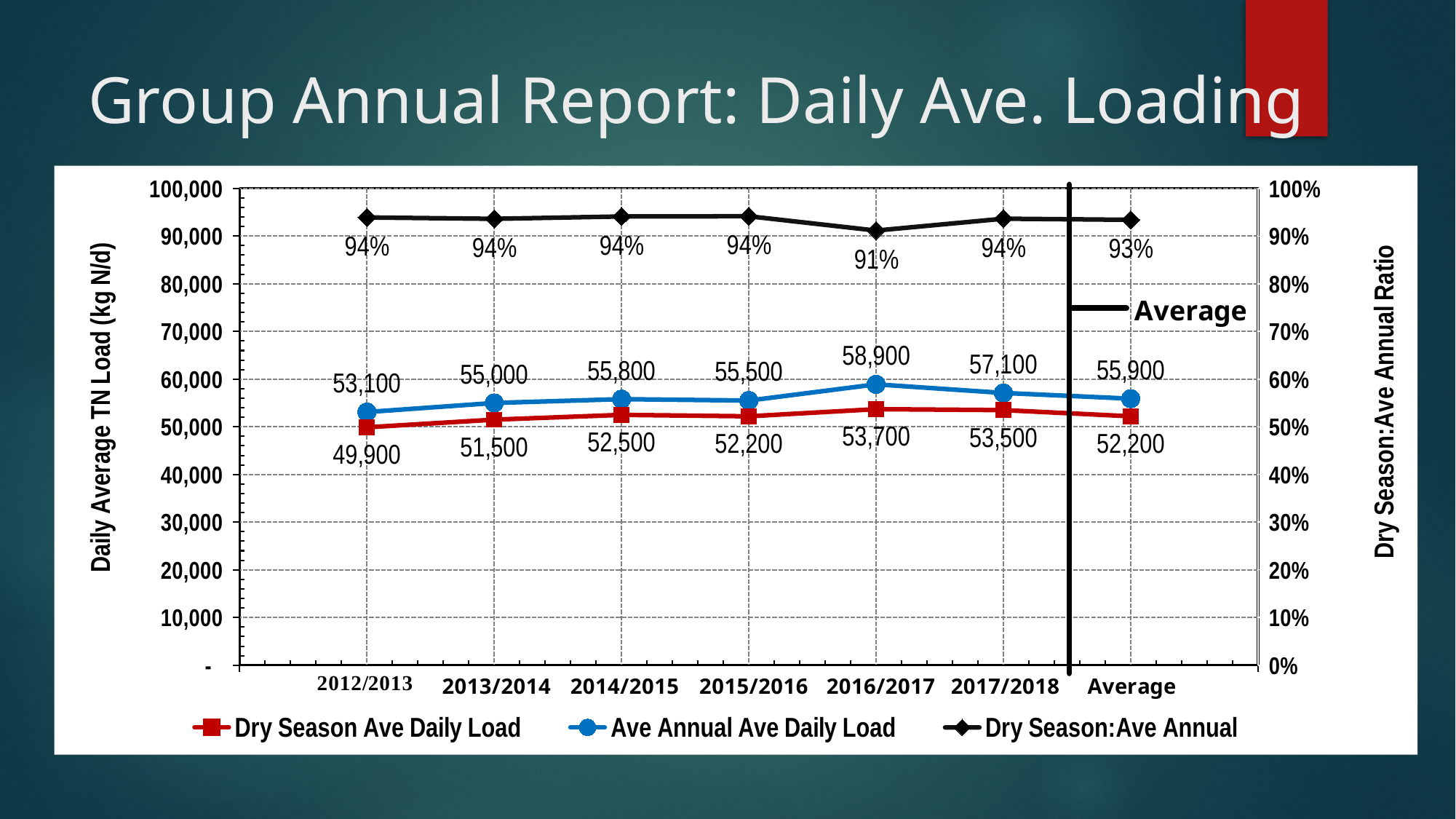
What is the label of the left vertical axis? Daily Average TN Load (kg N/d) Which is larger, the Dry Season Ave Daily Load in 2014/2015 or in 2017/2018? 2017/2018 In which year is the Dry Season Ave Daily Load lowest? 2012/2013 How many series does the legend list? 3 What is the Ave Annual Ave Daily Load for 2016/2017? 58,900 How many categories are shown on the x axis? 7 What is the Dry Season Ave Daily Load for 2012/2013? 49,900 What is the Dry Season Ave Daily Load for the Average category? 52,200 In which year is the Ave Annual Ave Daily Load highest? 2016/2017 What kind of chart is shown on the slide? line chart What is the difference between the Ave Annual Ave Daily Load and the Dry Season Ave Daily Load in 2016/2017? 5,200 What is the Dry Season:Ave Annual ratio for 2016/2017? 91%